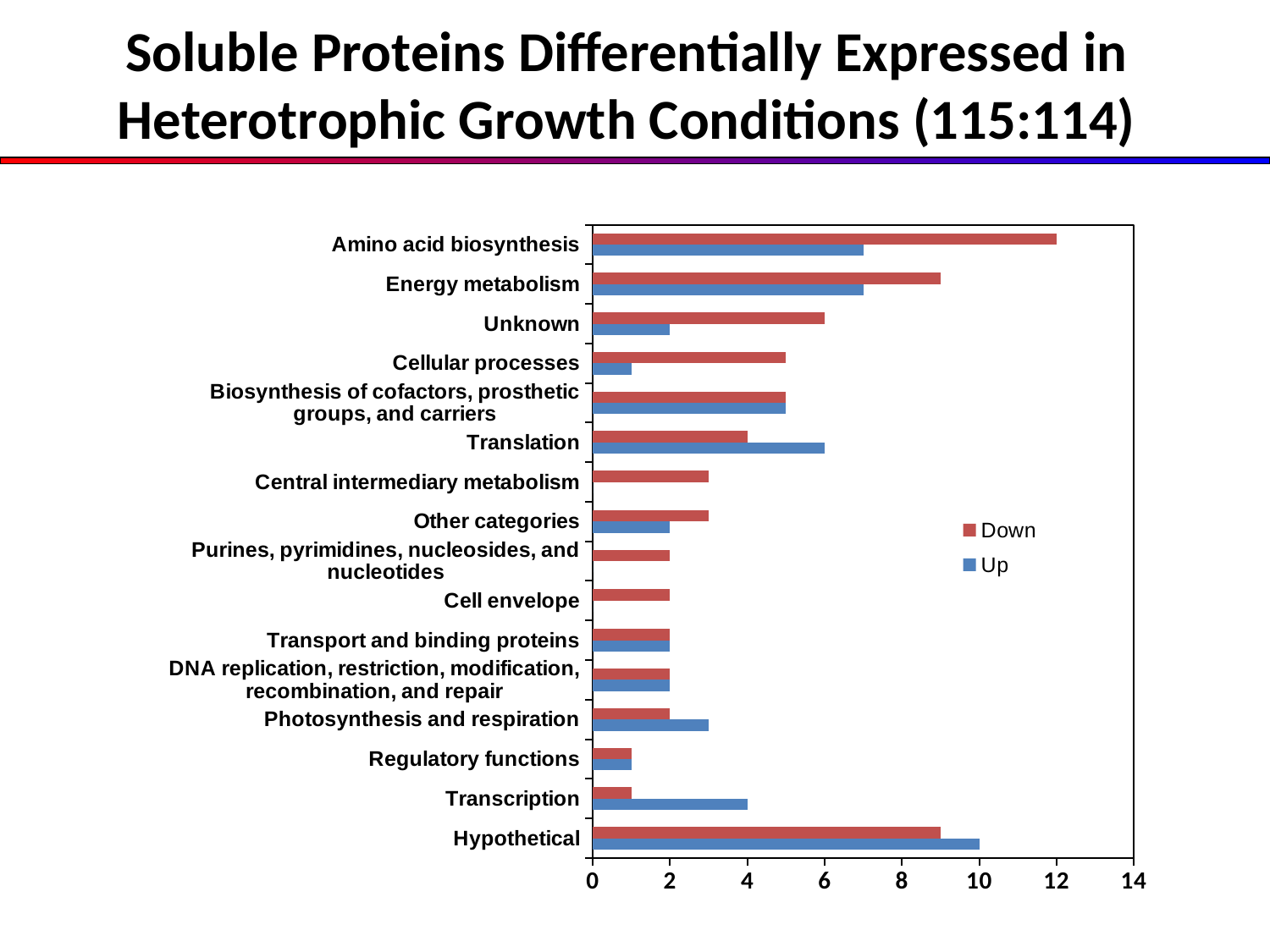
Which category has the highest Down value? Amino acid biosynthesis Which category has the highest Up value? Hypothetical Is the Down value for Energy metabolism greater or less than 8? greater How many series does the legend list? 2 What type of chart is shown on the slide? bar chart What is the Down value for Amino acid biosynthesis? 12 How many categories are plotted on the chart? 16 What is the Up value for Transcription? 4 For Transcription, which is larger, the Up value or the Down value? Up What is the Up value for Hypothetical? 10 What is the Up value for Translation? 6 What is the difference between the Up and Down values for Translation? 2